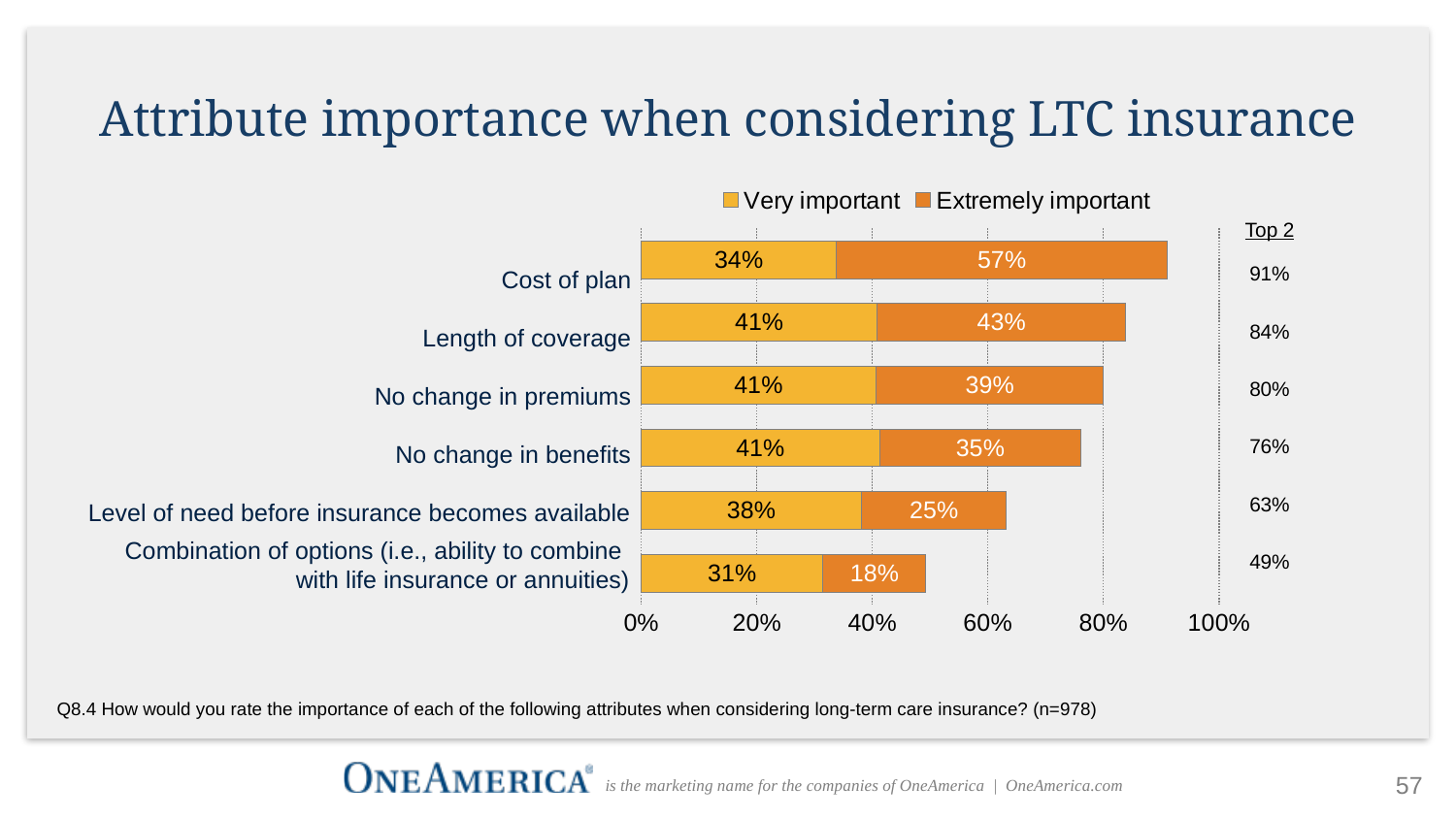
How many attributes are shown in the chart? 6 What percentage rated 'Cost of plan' as Extremely important? 57% Which is larger: the Extremely important value for 'No change in premiums' or for 'No change in benefits'? No change in premiums What type of chart is shown on the slide? Stacked bar chart What is the combined total of the stacked bar for 'No change in premiums'? 80% Which attribute has the highest Extremely important percentage? Cost of plan What is the Top 2 total for 'Level of need before insurance becomes available'? 63% What is the Extremely important value for 'Combination of options (i.e., ability to combine with life insurance or annuities)'? 18% What is the difference between the Extremely important values for 'Cost of plan' and 'Length of coverage'? 14% How many series does the legend list? 2 Which attribute has the lowest Very important percentage? Combination of options (i.e., ability to combine with life insurance or annuities) What percentage rated 'Length of coverage' as Very important? 41%